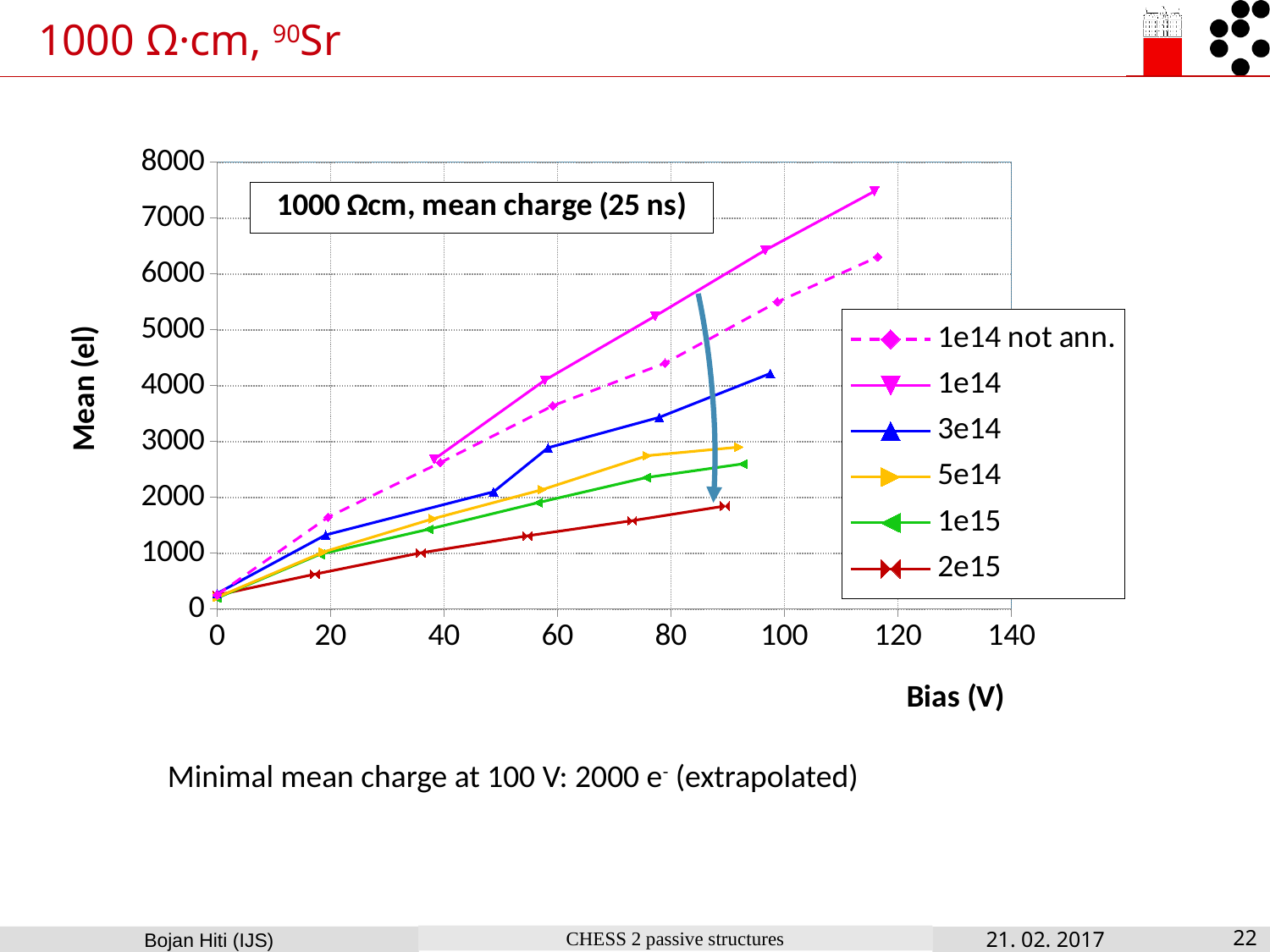
Which series has the lowest mean charge across the bias range? 2e15 Which series reaches the highest mean charge on the chart? 1e14 What is the title printed inside the chart? 1000 Ωcm, mean charge (25 ns) What kind of chart is shown on the slide? line chart Is the highest value of the 2e15 series greater or less than 2000? less Do the values of the 1e14 series rise or fall as bias increases? rise Is the highest value of the 3e14 series greater or less than 4000? greater Is the highest value of the 1e14 series greater or less than 7000? greater At a bias of 60 V, which series has the larger mean charge, 1e14 or 3e14? 1e14 What is the label of the x axis? Bias (V) How many series does the legend list? 6